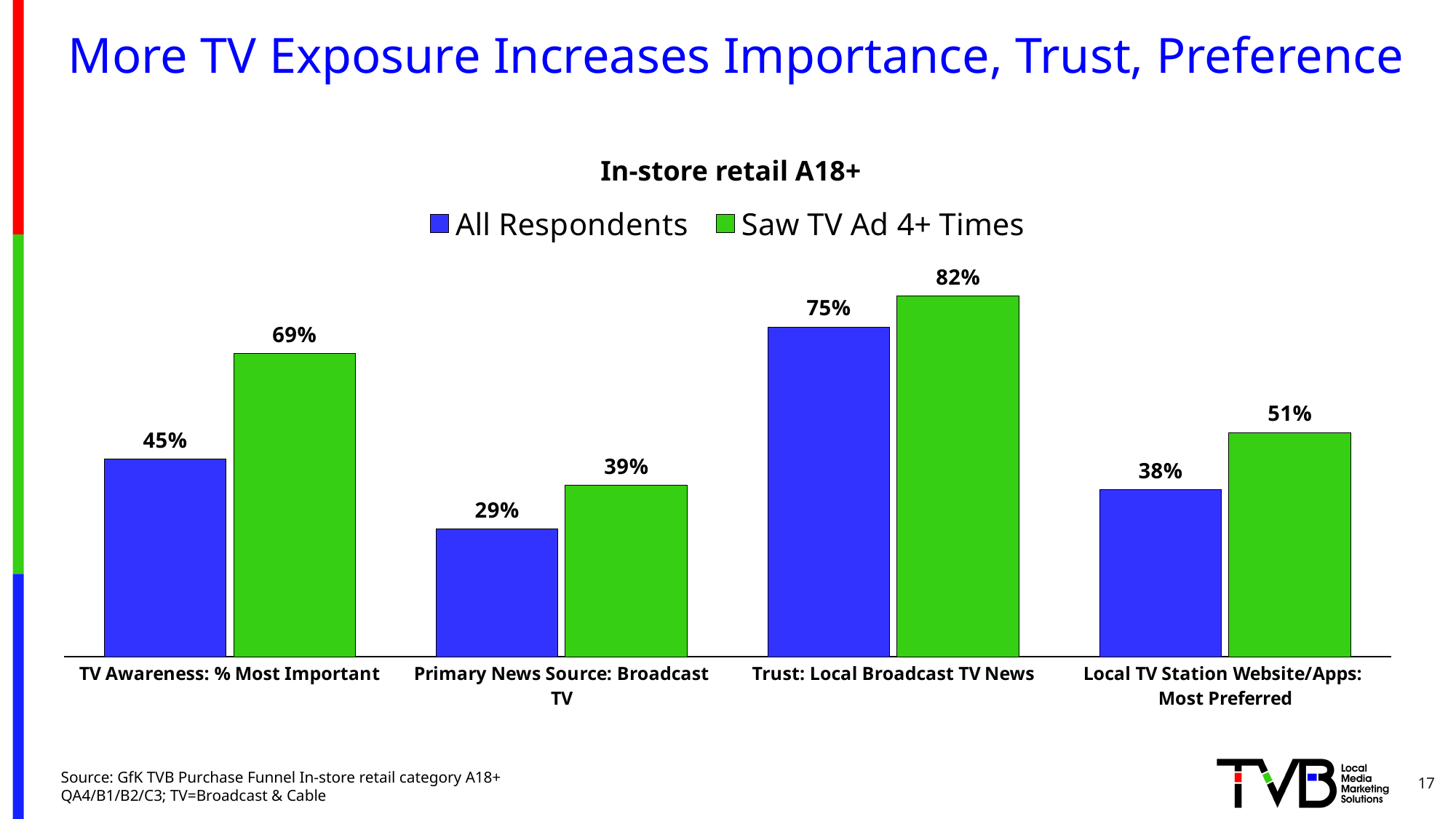
Which is larger in the Local TV Station Website/Apps: Most Preferred category: All Respondents or Saw TV Ad 4+ Times? Saw TV Ad 4+ Times What is the value for Saw TV Ad 4+ Times in the Trust: Local Broadcast TV News category? 82% Which category has the lowest value for Saw TV Ad 4+ Times? Primary News Source: Broadcast TV How many categories are shown on the x axis? 4 What kind of chart is shown on the slide? Bar chart What is the difference between the Saw TV Ad 4+ Times and All Respondents values in the TV Awareness: % Most Important category? 24% What is the value for Saw TV Ad 4+ Times in the Primary News Source: Broadcast TV category? 39% What is the value for All Respondents in the Local TV Station Website/Apps: Most Preferred category? 38% What is the title of the chart? In-store retail A18+ How many series does the legend list? 2 Which category has the highest value for All Respondents? Trust: Local Broadcast TV News What is the value for All Respondents in the TV Awareness: % Most Important category? 45%